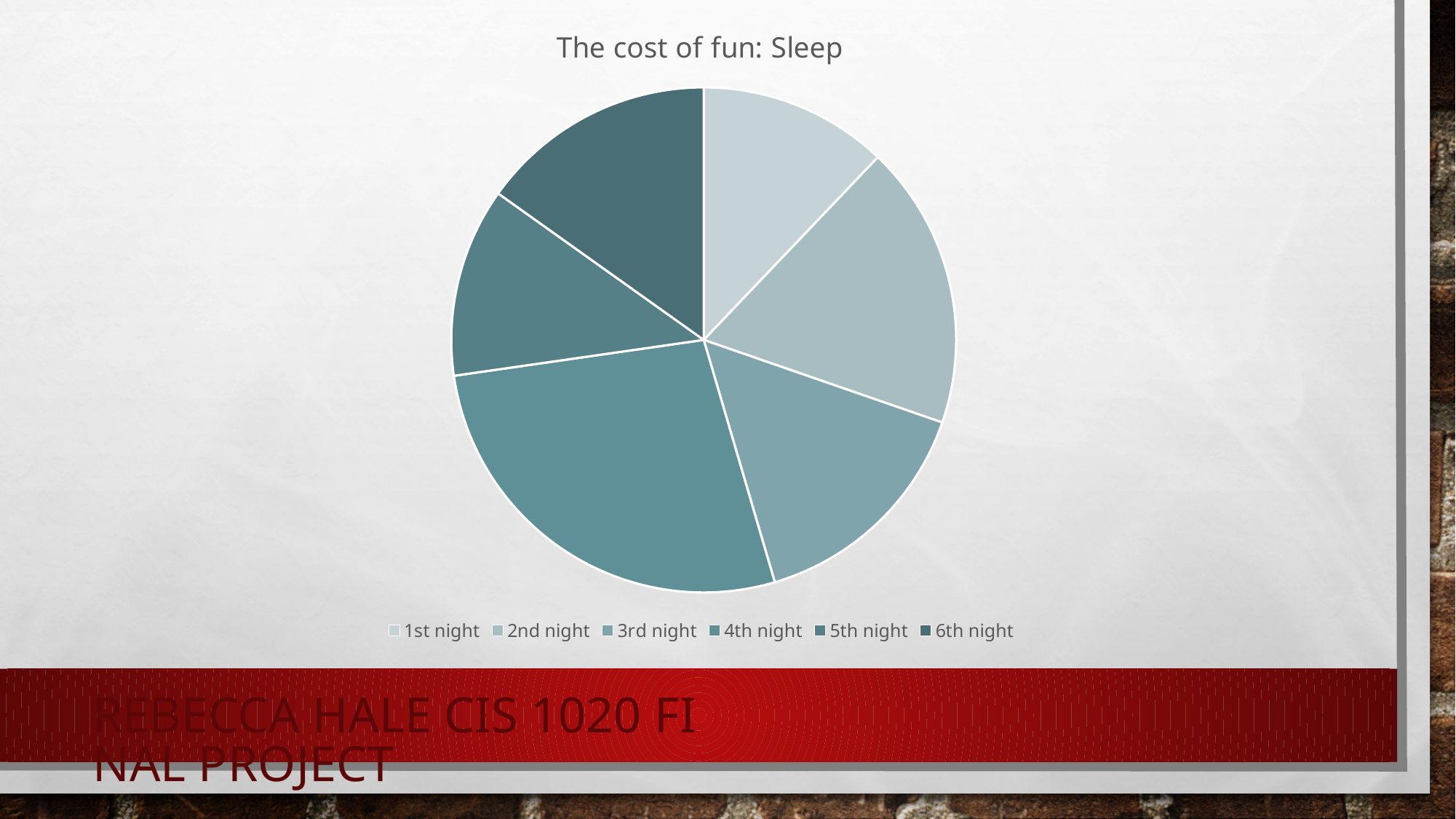
Which slice is larger, 4th night or 5th night? 4th night Which legend entry is listed first? 1st night What kind of chart is shown on the slide? pie chart Which slice is larger, 2nd night or 1st night? 2nd night Which slice is larger, 4th night or 1st night? 4th night Which night has the largest slice of the pie? 4th night How many slices does the pie chart have? 6 What is the title of the chart? The cost of fun: Sleep How many entries does the legend list? 6